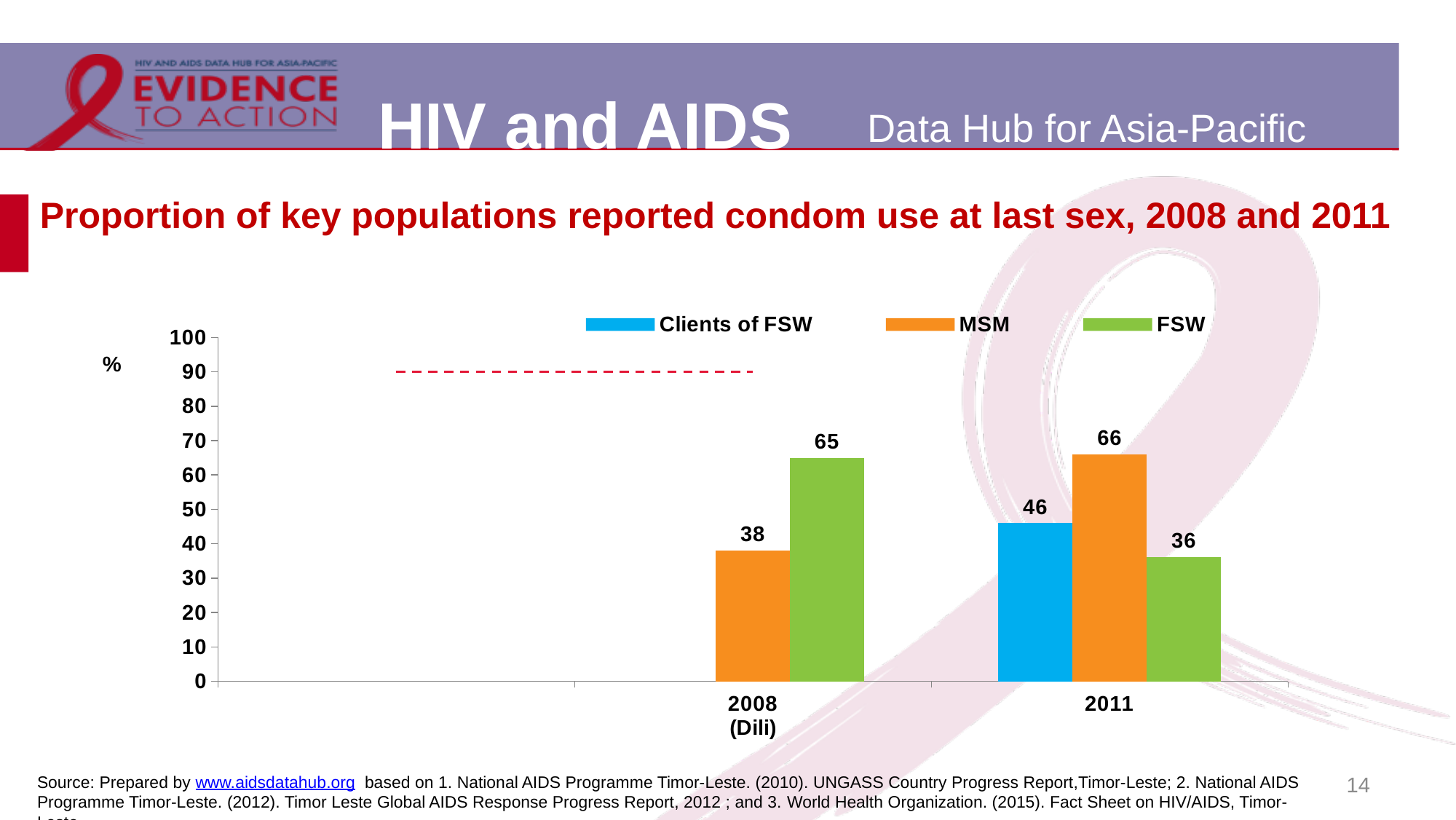
How many series does the legend list? 3 What colour represents Clients of FSW in the legend? Blue What is the difference between the FSW values in 2008 (Dili) and 2011? 29 Which series has the highest value in 2011? MSM What is the value for Clients of FSW in 2011? 46 What is the value for FSW in 2011? 36 Which is larger, the MSM value in 2008 (Dili) or the MSM value in 2011? 2011 Does the FSW value rise or fall from 2008 (Dili) to 2011? Fall What is the value for MSM in 2008 (Dili)? 38 What is the difference between the MSM and FSW values in 2011? 30 What kind of chart is shown on the slide? Bar chart Which series has the lowest value in 2011? FSW